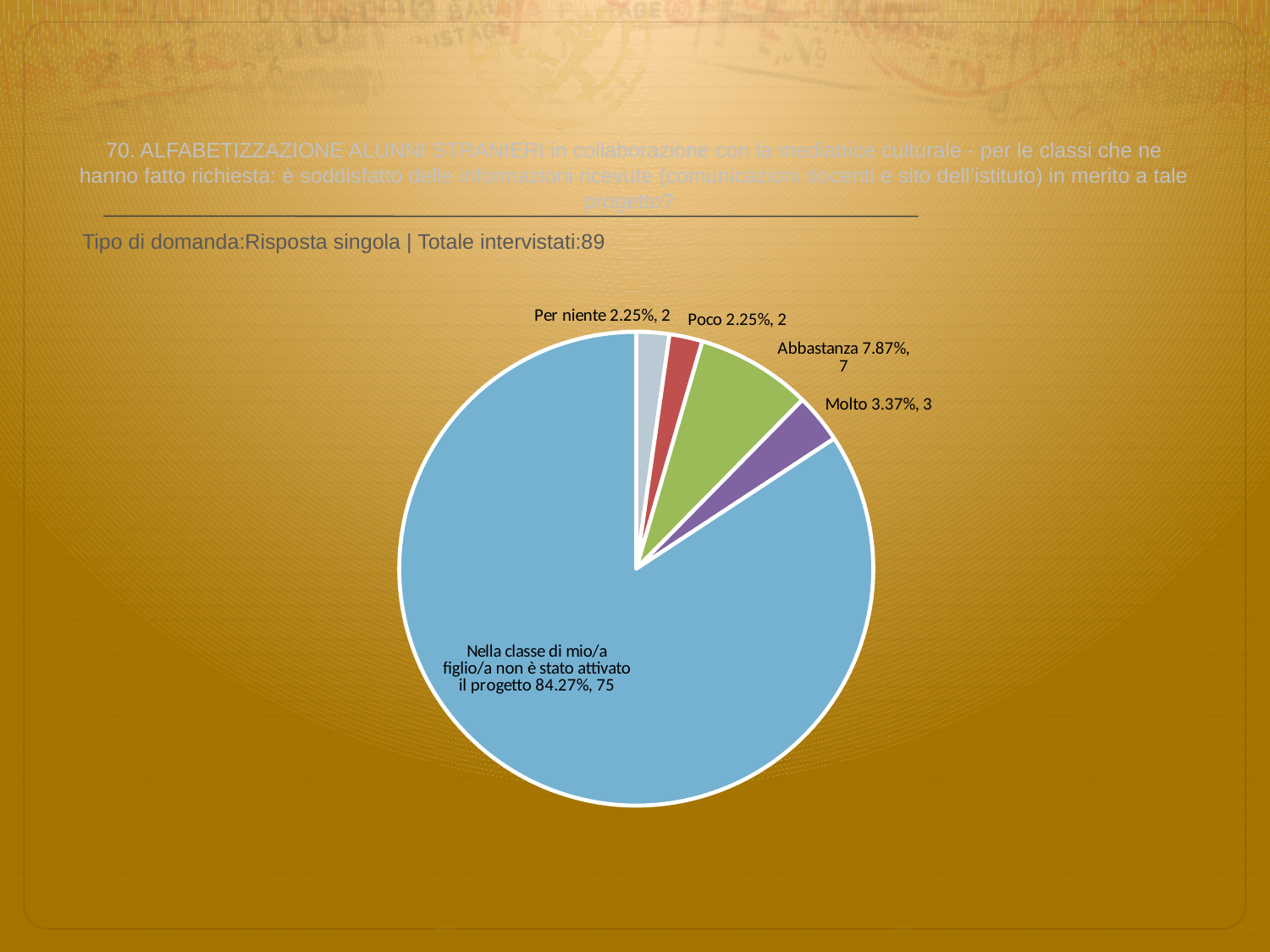
How many respondents answered "Poco"? 2 How many respondents answered "Per niente"? 2 How many respondents answered "Molto"? 3 What is the total number of respondents stated on the slide? 89 How many slices does the pie chart have? 5 What percentage share does the largest slice, "Nella classe di mio/a figlio/a non è stato attivato il progetto", have? 84.27% Which category has the largest slice of the pie? Nella classe di mio/a figlio/a non è stato attivato il progetto What percentage share does the "Molto" slice have? 3.37% Which is larger, the count for "Abbastanza" or the count for "Molto"? Abbastanza What kind of chart is shown on the slide? pie chart What is the difference between the number of respondents for "Abbastanza" and for "Molto"? 4 What percentage share does the "Abbastanza" slice have? 7.87%